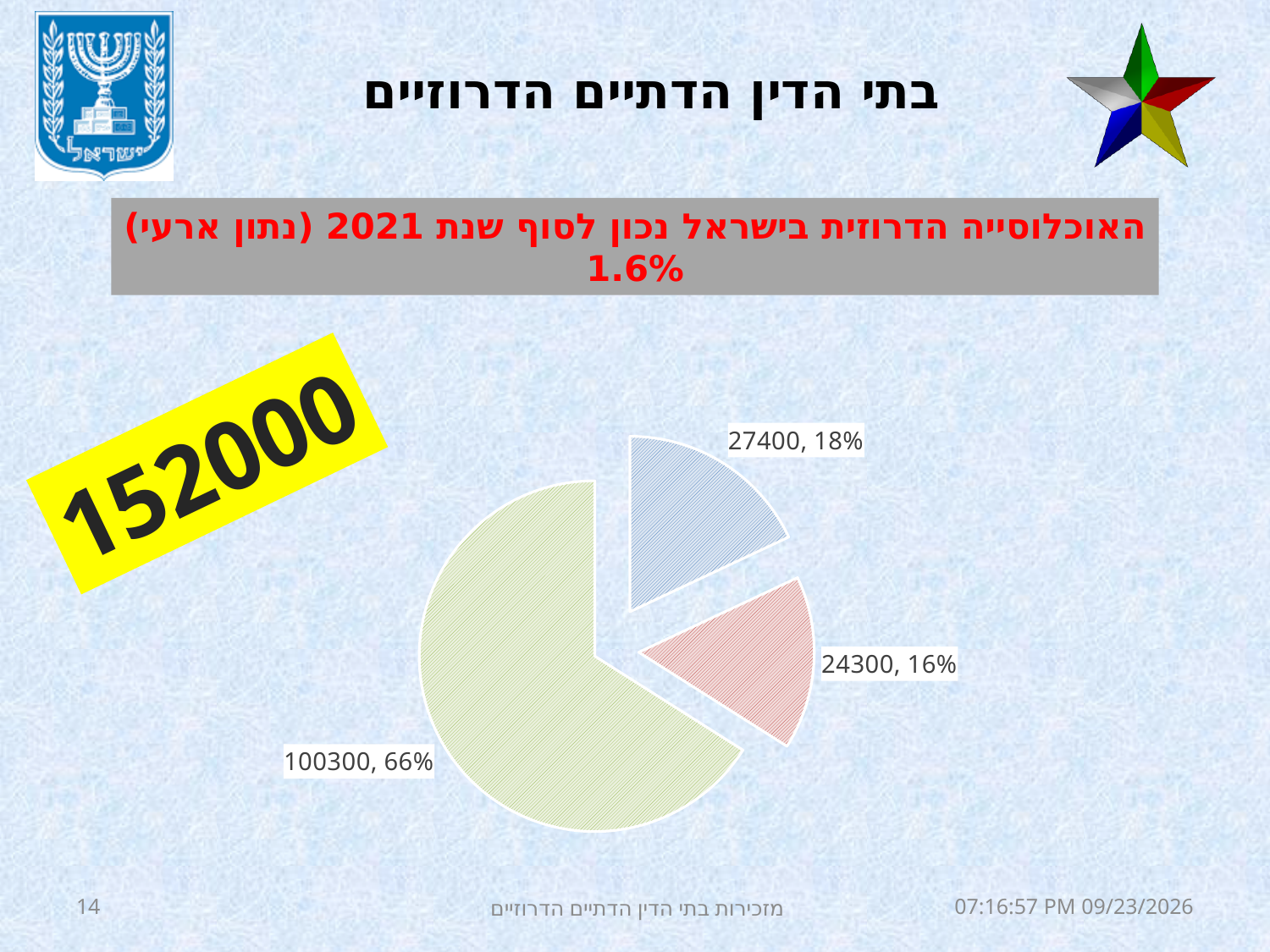
How many slices does the pie chart have? 3 What is the total of all three slice values in the pie chart? 152000 What value is shown for the largest slice of the pie chart? 100300 What share of the pie does the red slice represent? 16% What value is shown on the blue slice of the pie chart? 27400 What share of the pie does the blue slice represent? 18% What kind of chart is shown on the slide? pie chart What value is shown on the red slice of the pie chart? 24300 What value is shown for the smallest slice of the pie chart? 24300 What share of the pie does the green slice represent? 66% Which slice has the larger value, the blue slice or the red slice? blue slice What is the difference between the values of the blue slice and the red slice? 3100